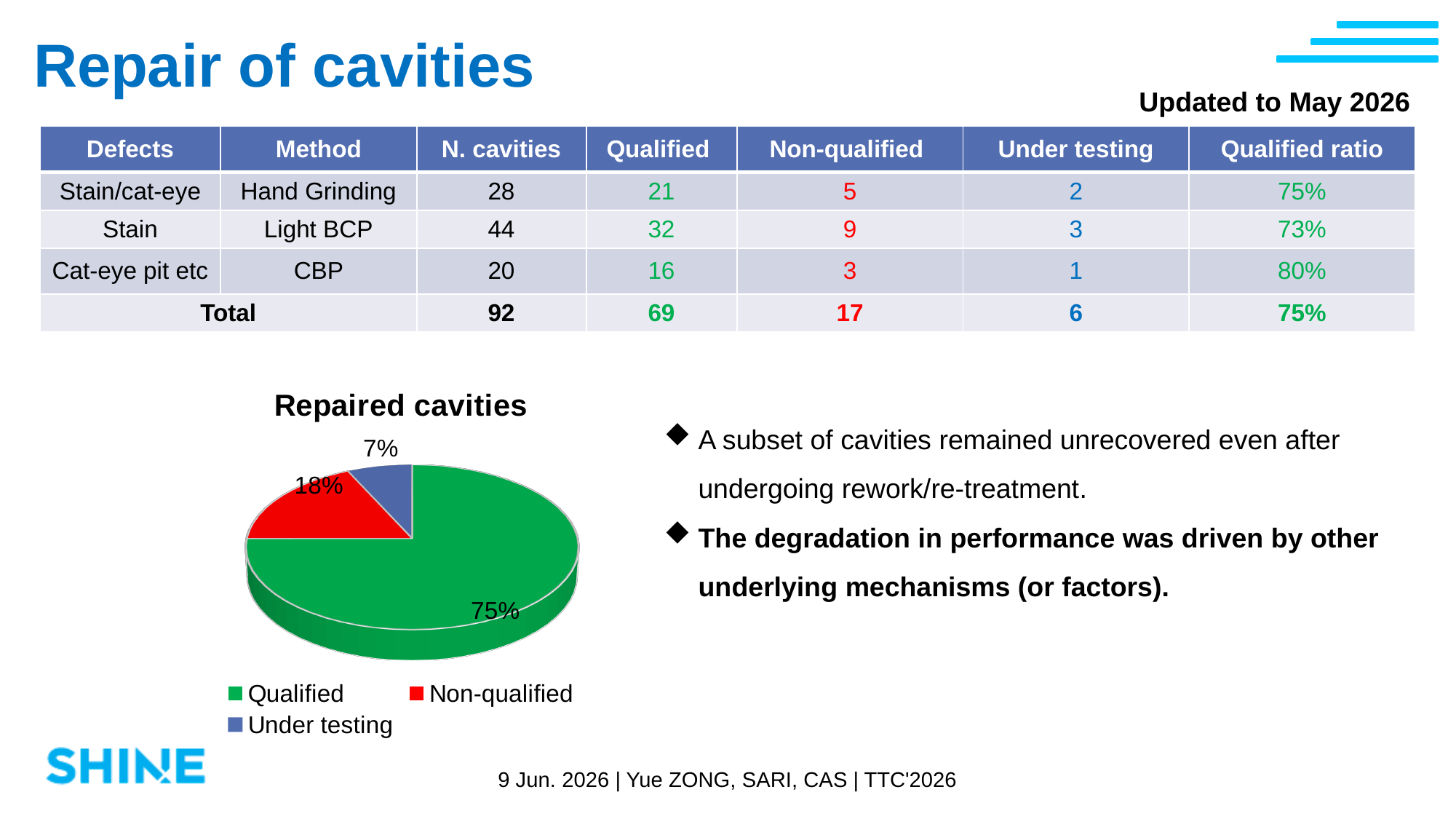
How many slices does the pie chart have? 3 How many entries does the legend of the pie chart list? 3 What share of the pie does the Qualified slice represent? 75% Which slice of the pie chart is the largest? Qualified Which slice of the pie chart is the smallest? Under testing Which slice is larger, Non-qualified or Under testing? Non-qualified What colour is the Qualified slice in the pie chart? green What is the difference in percentage points between the Non-qualified and Under testing slices? 11% What is the title of the pie chart? Repaired cavities What share of the pie does the Non-qualified slice represent? 18% What share of the pie does the Under testing slice represent? 7% What kind of chart is the "Repaired cavities" chart? pie chart